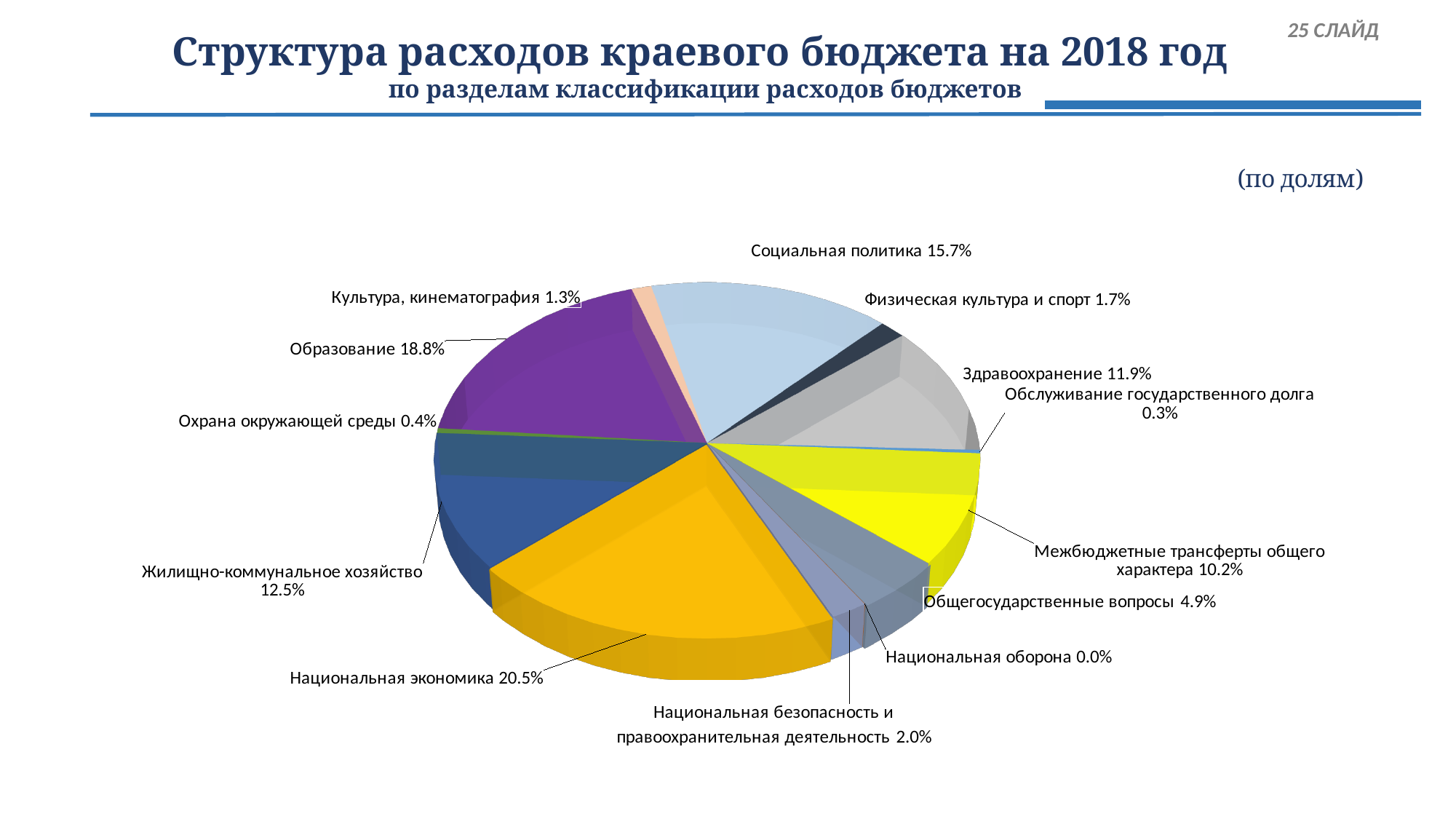
What share does Национальная экономика have in the pie chart? 20.5% What share does Обслуживание государственного долга have in the pie chart? 0.3% Which category has the largest share in the pie chart? Национальная экономика What share does Здравоохранение have in the pie chart? 11.9% What is the title of the chart on the slide? Структура расходов краевого бюджета на 2018 год по разделам классификации расходов бюджетов What type of chart is shown on the slide? pie chart Which category has the smallest share in the pie chart? Национальная оборона What share does Межбюджетные трансферты общего характера have in the pie chart? 10.2% Which has a larger share: Образование or Социальная политика? Образование How many categories are shown in the pie chart? 13 What share does Образование have in the pie chart? 18.8% What is the difference between the shares of Социальная политика and Жилищно-коммунальное хозяйство? 3.2%